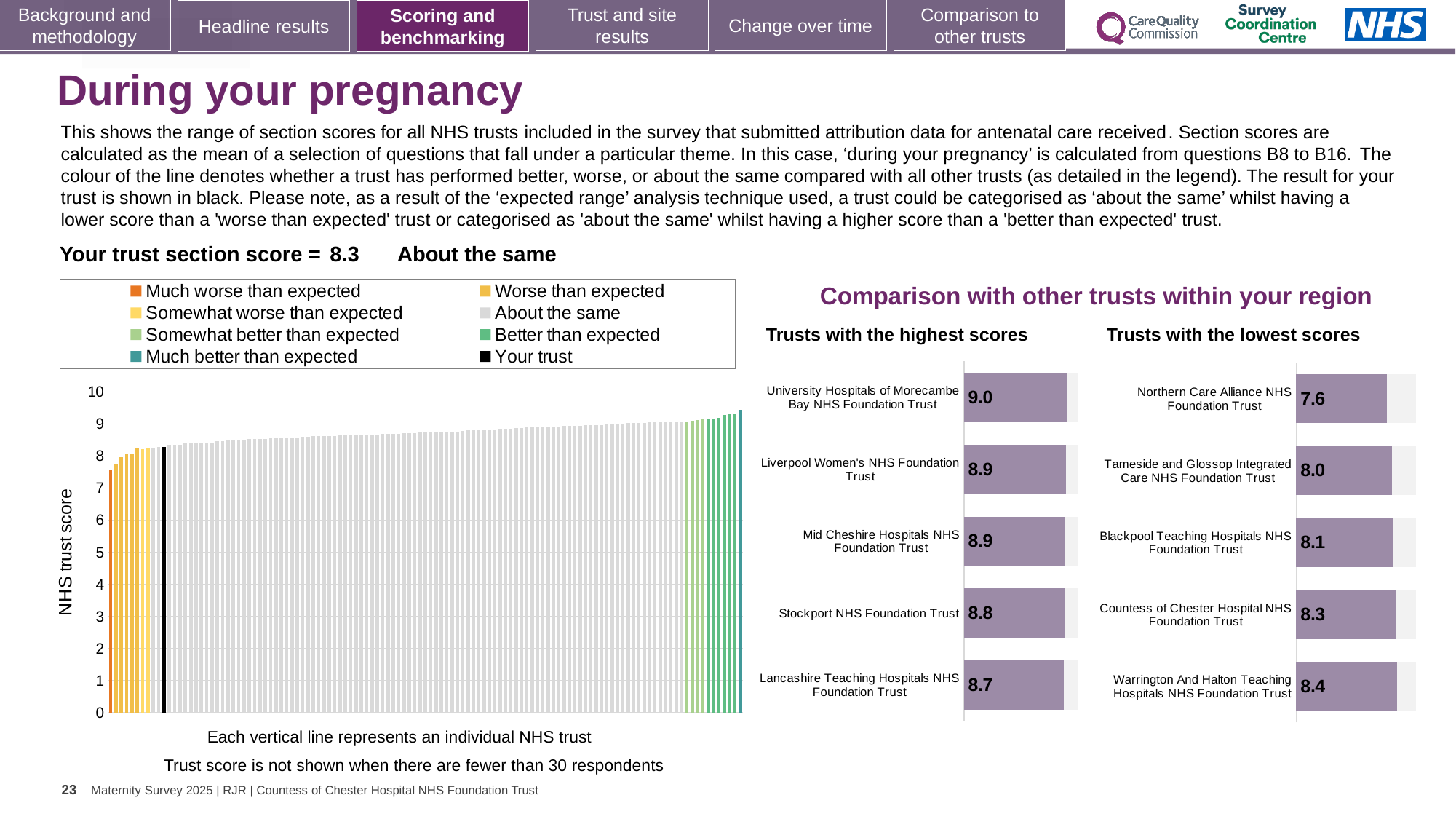
How many entries does the legend of the NHS trust score chart list? 8 In the 'Trusts with the highest scores' chart, what is the score for University Hospitals of Morecambe Bay NHS Foundation Trust? 9.0 In the 'Trusts with the highest scores' chart, what is the score for Stockport NHS Foundation Trust? 8.8 In the 'NHS trust score' chart on the left, do the values rise or fall from left to right along the x axis? Rise In the 'Trusts with the highest scores' chart, which trust has the lowest score? Lancashire Teaching Hospitals NHS Foundation Trust In the 'Trusts with the lowest scores' chart, which has the larger score: Tameside and Glossop Integrated Care NHS Foundation Trust or Countess of Chester Hospital NHS Foundation Trust? Countess of Chester Hospital NHS Foundation Trust What kind of chart is the 'NHS trust score' chart on the left? Bar chart In the 'Trusts with the lowest scores' chart, what is the score for Blackpool Teaching Hospitals NHS Foundation Trust? 8.1 In the 'Trusts with the lowest scores' chart, which trust has the highest score? Warrington And Halton Teaching Hospitals NHS Foundation Trust In the 'Trusts with the highest scores' chart, what is the difference between the scores of University Hospitals of Morecambe Bay NHS Foundation Trust and Lancashire Teaching Hospitals NHS Foundation Trust? 0.3 In the 'Trusts with the lowest scores' chart, what is the score for Northern Care Alliance NHS Foundation Trust? 7.6 How many trusts are shown in the 'Trusts with the lowest scores' chart? 5